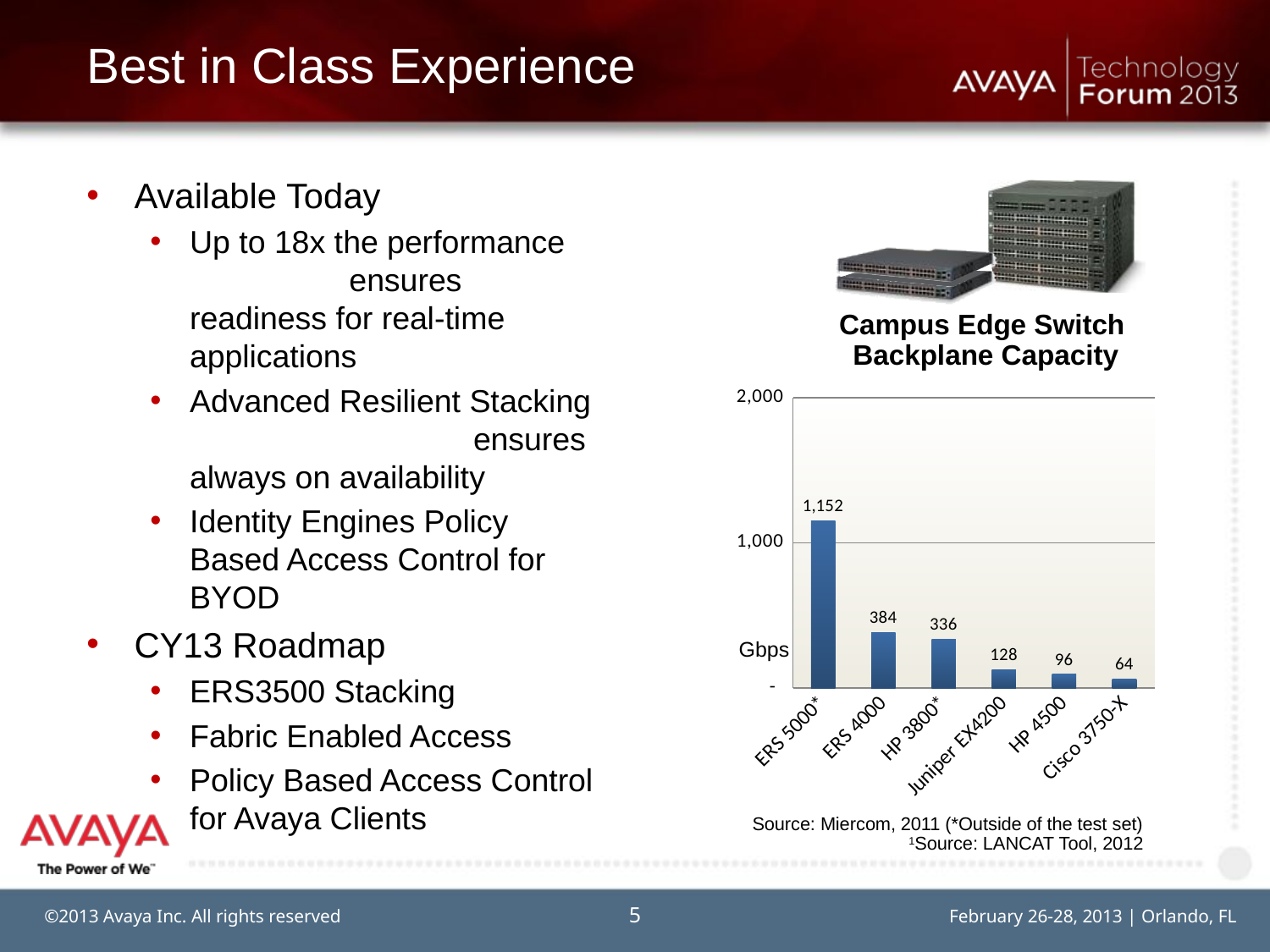
Which category has the lowest backplane capacity? Cisco 3750-X How many categories are shown on the x axis of the chart? 6 Which category has the highest backplane capacity? ERS 5000* What is the value shown for Juniper EX4200? 128 What is the title of the chart? Campus Edge Switch Backplane Capacity Which is larger, the value for HP 4500 or the value for Juniper EX4200? Juniper EX4200 What kind of chart is shown on the slide? Bar chart What is the difference between the values for ERS 5000* and ERS 4000? 768 What is the value shown for ERS 4000? 384 What is the value shown for Cisco 3750-X? 64 What is the backplane capacity value shown for ERS 5000*? 1,152 What is the value shown for HP 3800*? 336